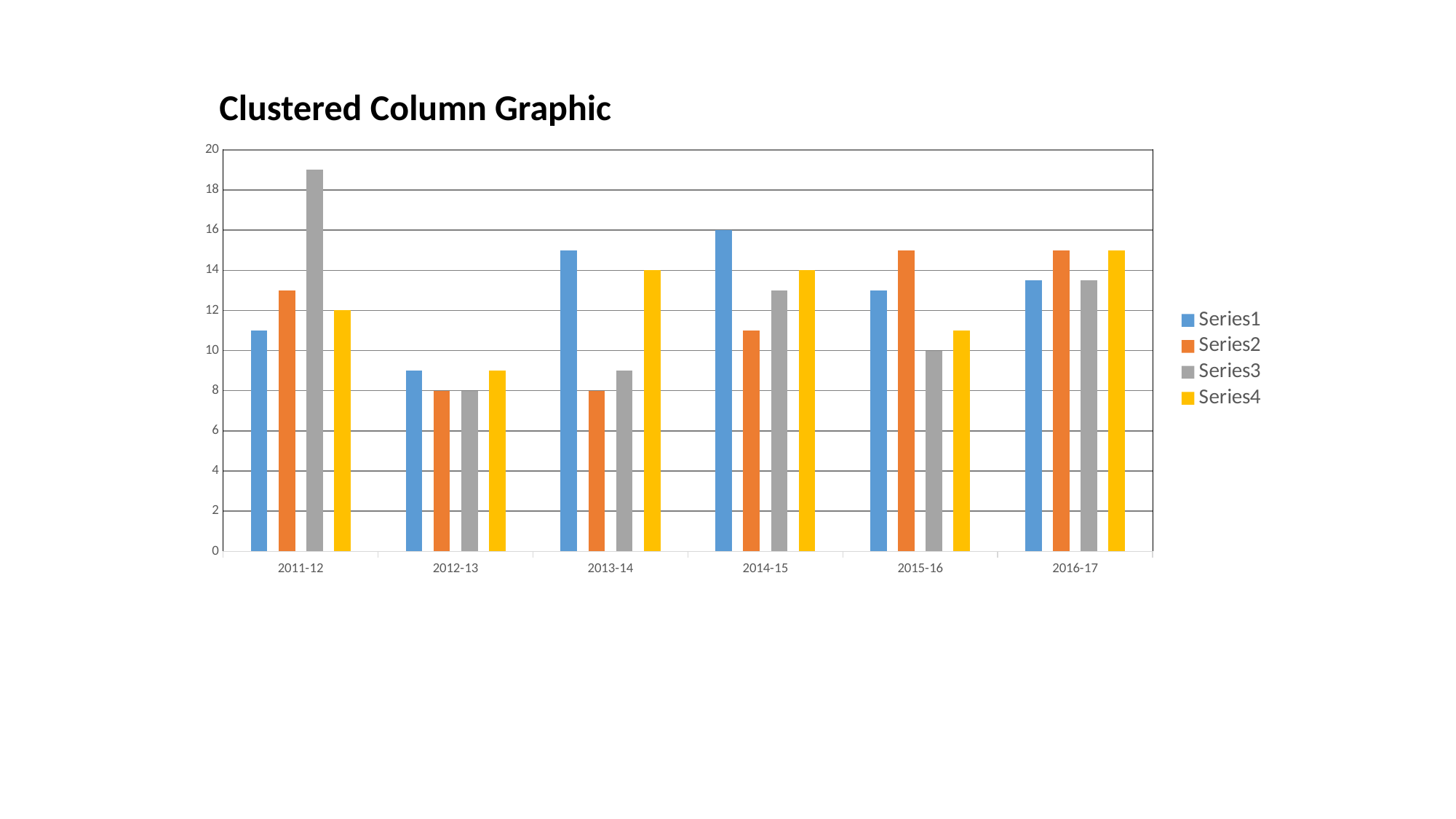
Which category has the highest value for Series3? 2011-12 Is the value for Series3 in 2011-12 greater or less than 18? greater How many series does the legend list? 4 What type of chart is shown on the slide? bar chart Which category has the lowest value for Series4? 2012-13 Is the value for Series2 in 2014-15 greater or less than 12? less What is the title of the chart? Clustered Column Graphic Which is larger: Series3 in 2012-13 or Series3 in 2014-15? Series3 in 2014-15 Which is larger: Series1 in 2014-15 or Series1 in 2015-16? Series1 in 2014-15 Is the value for Series1 in 2013-14 greater or less than 14? greater Which category has the lowest value for Series1? 2012-13 How many categories are shown on the x axis? 6